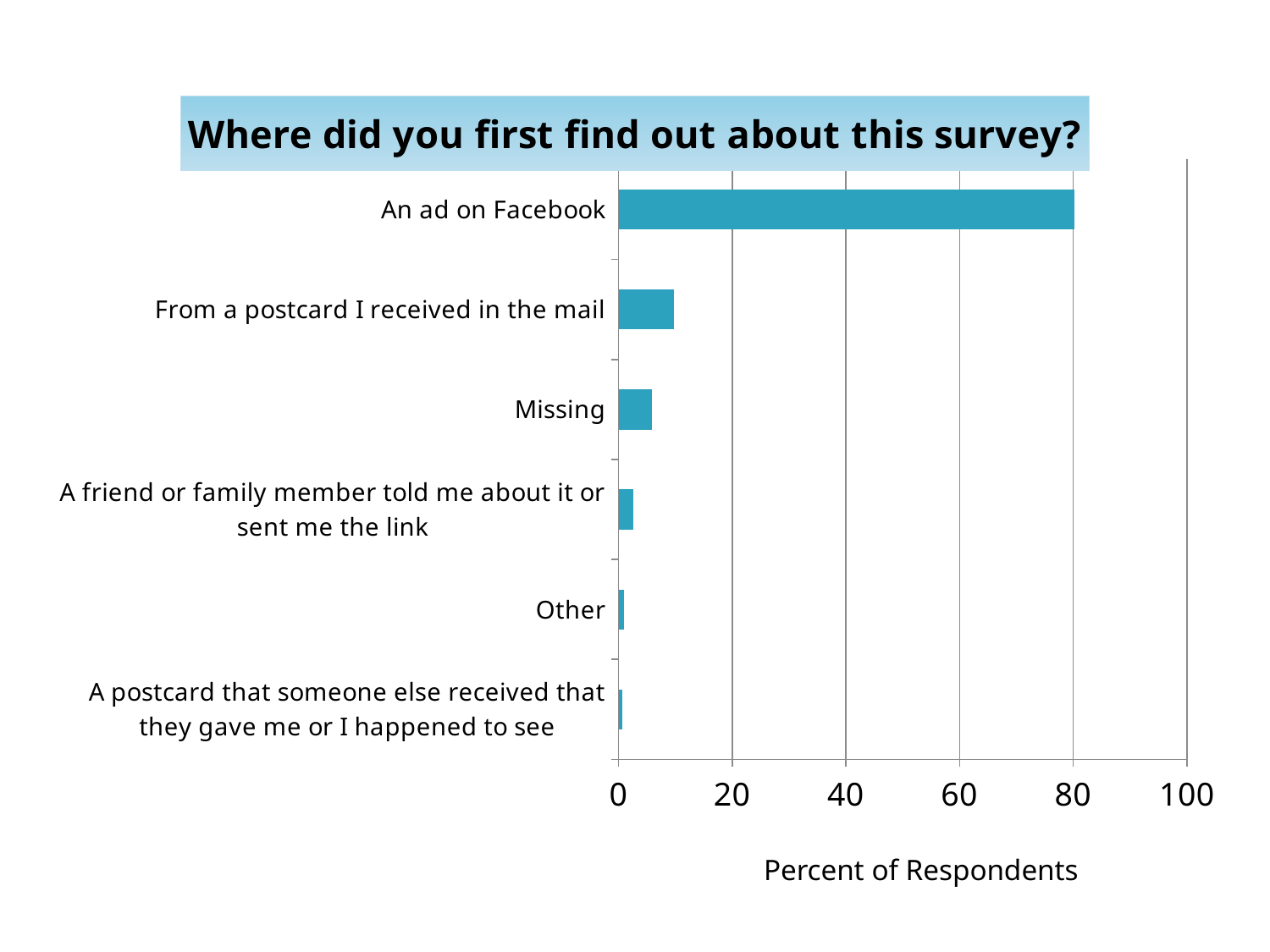
How many categories are shown in the chart? 6 Which category has the highest percent of respondents? An ad on Facebook Is the value for Missing greater or less than 20? less Which is larger: the value for Missing or the value for Other? Missing What kind of chart is shown on the slide? bar chart Which is larger: the value for From a postcard I received in the mail or the value for Missing? From a postcard I received in the mail What is the title of the chart? Where did you first find out about this survey? Is the value for An ad on Facebook greater or less than 100? less What is the label on the horizontal axis? Percent of Respondents Which category has the lowest percent of respondents? A postcard that someone else received that they gave me or I happened to see Is the value for An ad on Facebook greater or less than 60? greater